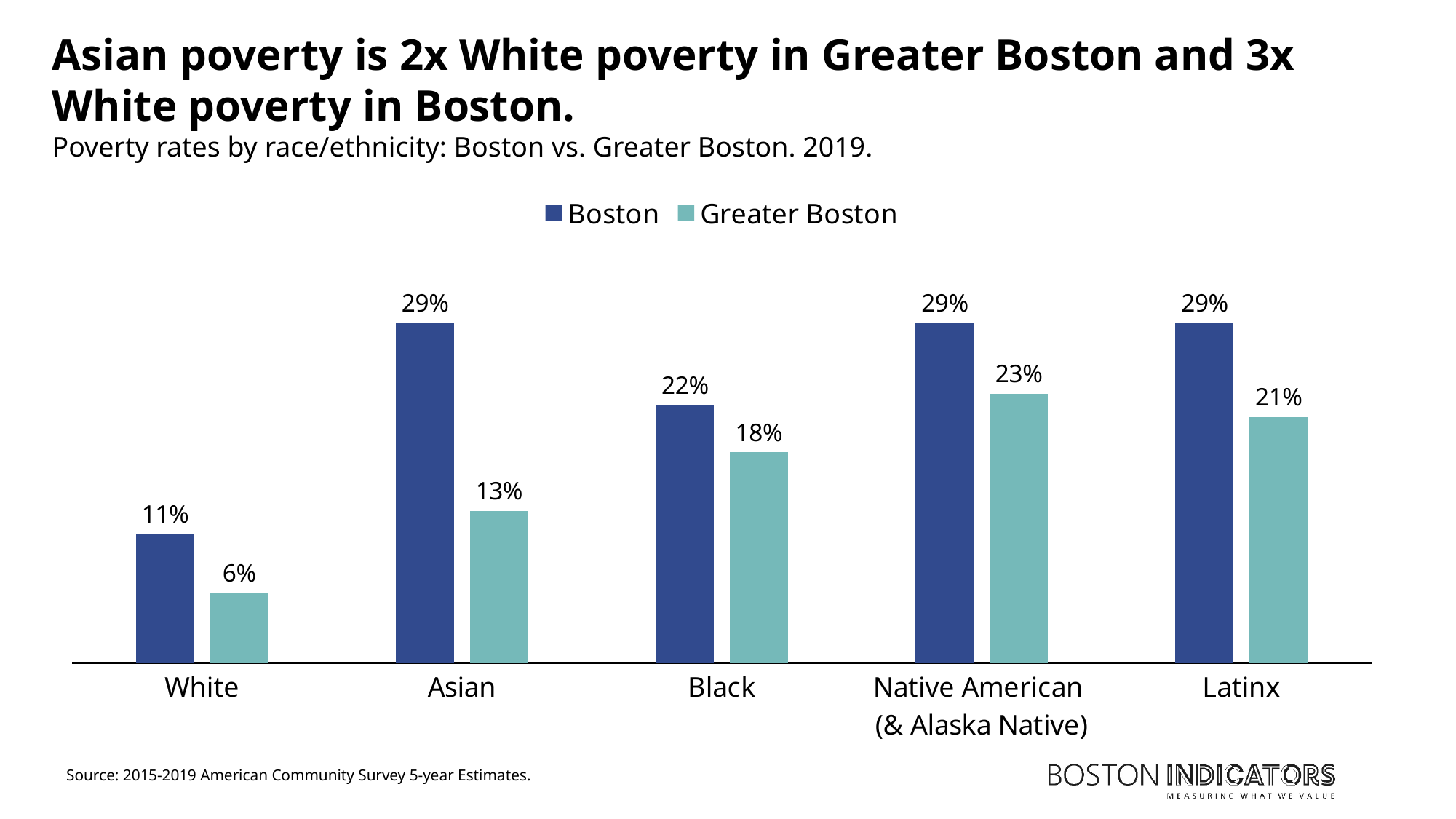
Which series is shown in dark blue? Boston How many series does the legend list? 2 What kind of chart is shown on the slide? Bar chart What is the Boston poverty rate for Latinx residents? 29% What is the Boston poverty rate for Asian residents? 29% Which race/ethnicity has the lowest Boston poverty rate? White Which is larger: the Greater Boston poverty rate for Latinx residents or for Black residents? Latinx What is the Greater Boston poverty rate for Black residents? 18% How many race/ethnicity categories are shown on the chart? 5 What is the difference between the Boston and Greater Boston poverty rates for Asian residents? 16 percentage points What is the Greater Boston poverty rate for White residents? 6% Which race/ethnicity has the highest Greater Boston poverty rate? Native American (& Alaska Native)